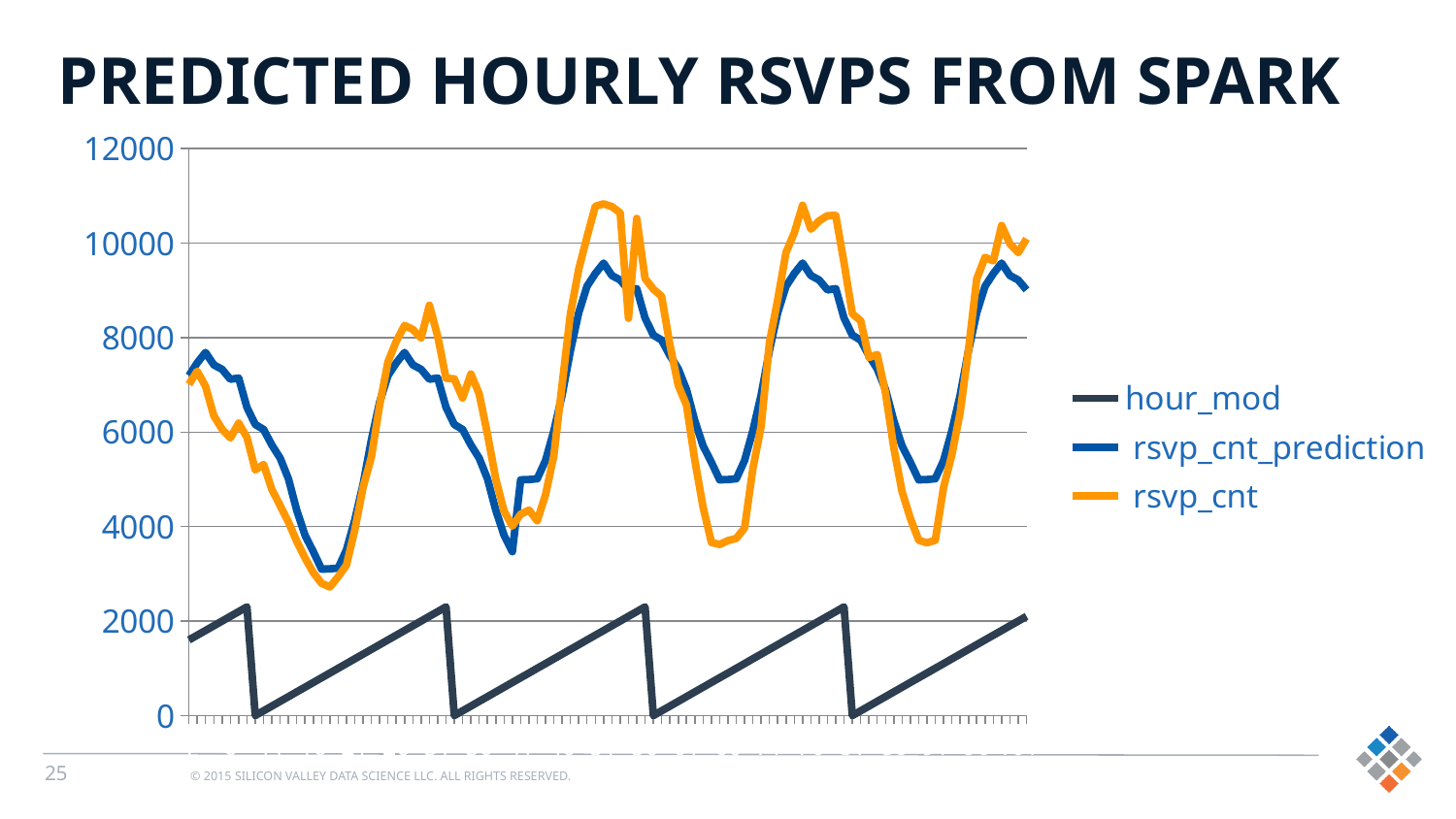
Which series has the higher peak, rsvp_cnt or rsvp_cnt_prediction? rsvp_cnt Which series is drawn in orange? rsvp_cnt What is the lowest value the hour_mod series drops to? 0 Is the highest value of rsvp_cnt_prediction greater or less than 10000? less Which series reaches the highest peak value on the chart? rsvp_cnt Is the highest value of hour_mod greater or less than 4000? less How many series does the legend list? 3 Is the lowest value of rsvp_cnt greater or less than 2000? greater What is the title of the chart? PREDICTED HOURLY RSVPS FROM SPARK Which series stays lowest across the whole chart? hour_mod What kind of chart is shown on the slide? line chart